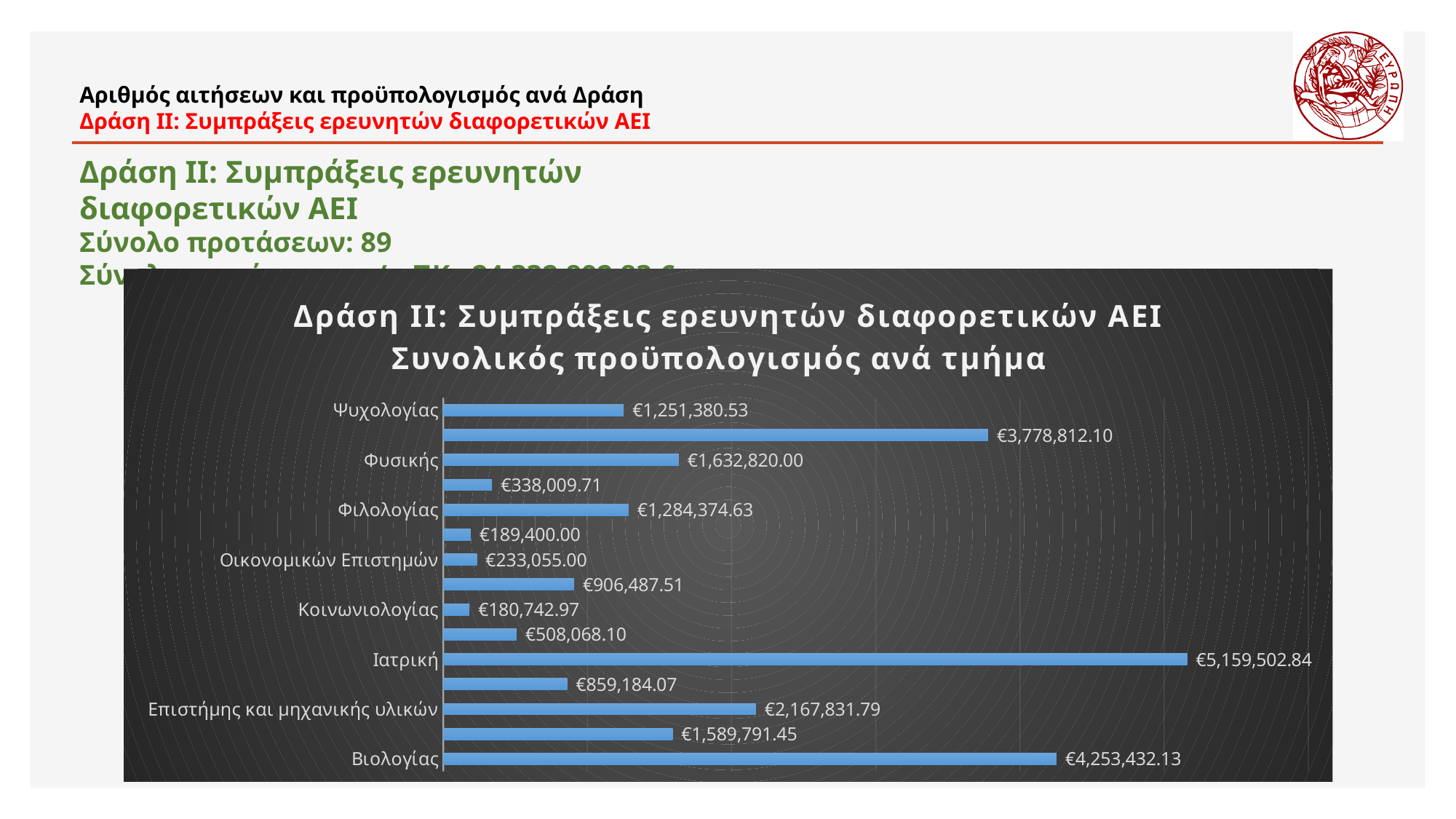
What type of chart is shown on the slide? Bar chart What is the difference between the budgets of Ιατρική and Βιολογίας? €906,070.71 What is the total budget for Οικονομικών Επιστημών? €233,055.00 How many bars are plotted in the chart? 15 Which labelled department has the lowest total budget? Κοινωνιολογίας What is the total budget for Επιστήμης και μηχανικής υλικών? €2,167,831.79 What is the difference between the budgets of Φυσικής and Ψυχολογίας? €381,439.47 What is the total budget for Ψυχολογίας? €1,251,380.53 Which has a larger budget, Επιστήμης και μηχανικής υλικών or Φυσικής? Επιστήμης και μηχανικής υλικών What is the total budget for Βιολογίας? €4,253,432.13 Which department has the highest total budget? Ιατρική What is the total budget for Ιατρική? €5,159,502.84